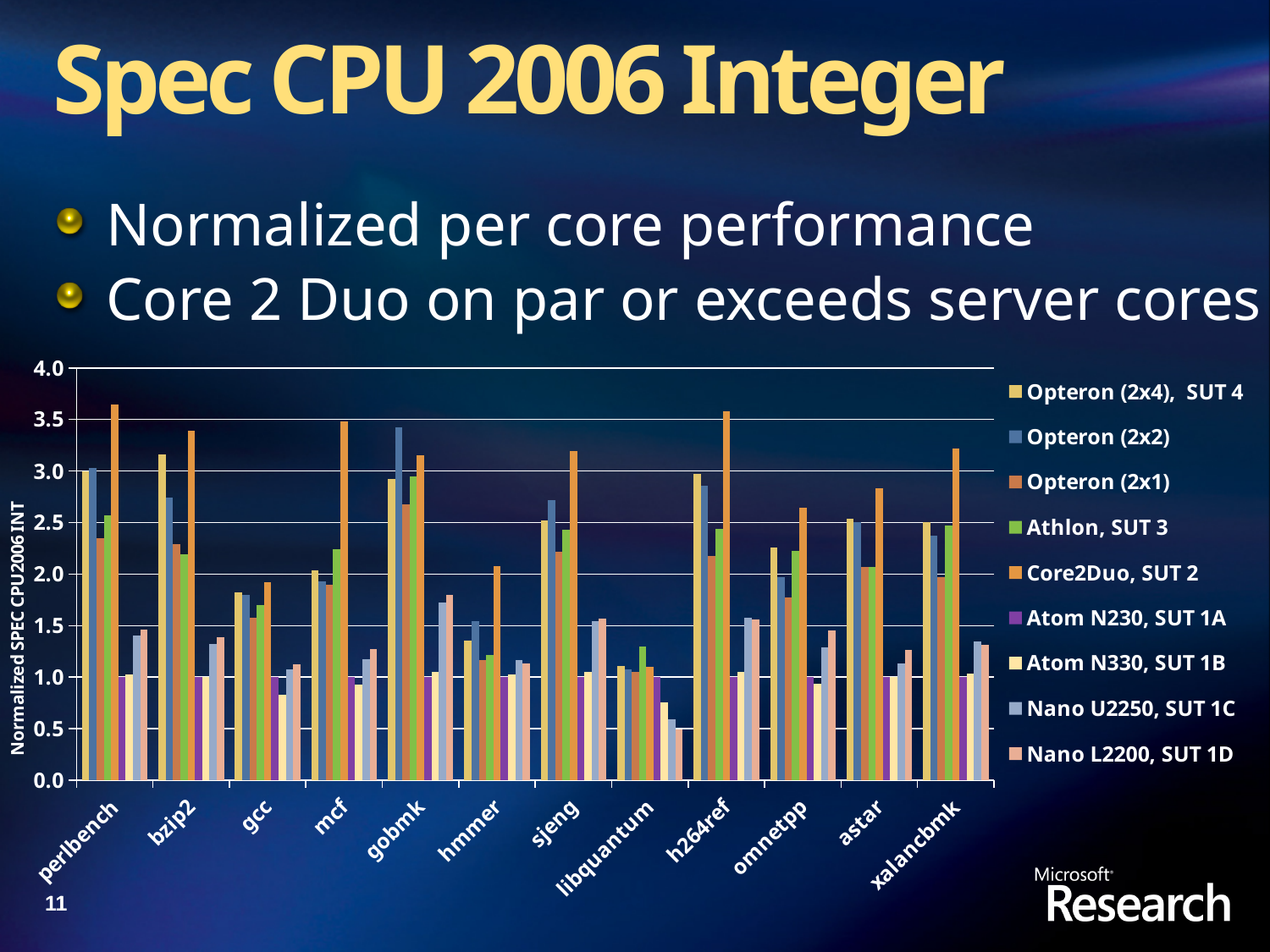
What is the title of the chart's vertical axis? Normalized SPEC CPU2006 INT For mcf, which is larger: the Athlon, SUT 3 bar or the Opteron (2x1) bar? Athlon, SUT 3 Is the value for Opteron (2x4), SUT 4 on bzip2 greater or less than 3.0? greater For gobmk, which is larger: the Opteron (2x2) bar or the Opteron (2x4), SUT 4 bar? Opteron (2x2) How many benchmark categories are shown on the x axis of the chart? 12 Is the value for Opteron (2x2) on gobmk greater or less than 3.0? greater Is the value for Core2Duo, SUT 2 on perlbench greater or less than 3.5? greater What kind of chart is shown on the slide? bar chart Which series has the highest bar for perlbench? Core2Duo, SUT 2 For which benchmark is the Core2Duo, SUT 2 bar the lowest? libquantum How many series does the chart's legend list? 9